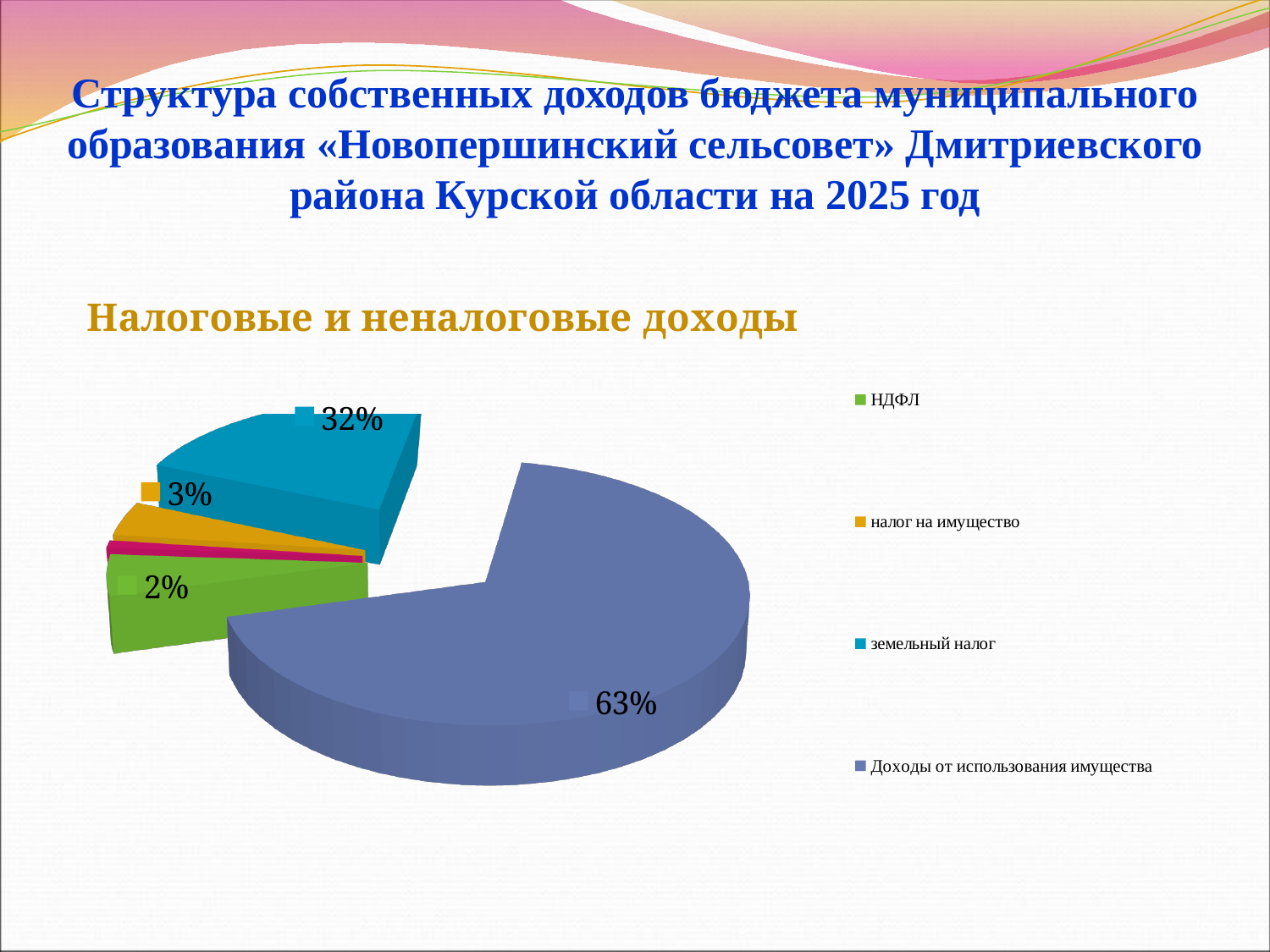
What percentage does налог на имущество make up? 3% Which category has the largest share of the pie? Доходы от использования имущества Which is larger, the share for земельный налог or for налог на имущество? земельный налог What type of chart is shown on the slide? Pie chart What share of the pie does земельный налог account for? 32% What share is labelled for НДФЛ? 2% What percentage is shown for Доходы от использования имущества? 63% Which labelled category has the smallest share of the pie? НДФЛ What is the title of the chart? Налоговые и неналоговые доходы How many entries does the legend list? 4 Which category is shown in green in the chart? НДФЛ By how many percentage points does Доходы от использования имущества exceed земельный налог? 31 percentage points